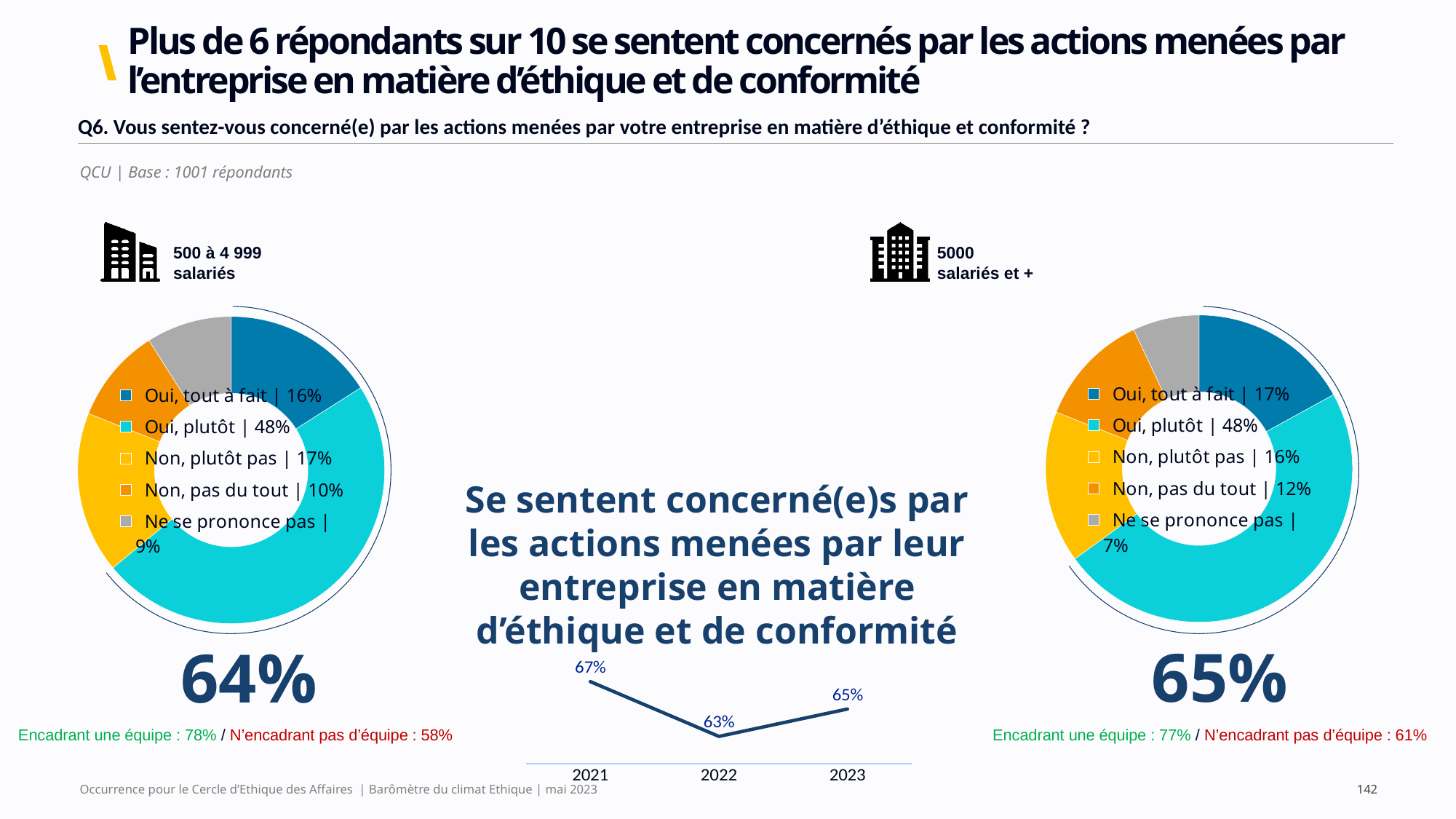
In the right donut chart (5000 salariés et +), which response category has the smallest share? Ne se prononce pas In the left donut chart (500 à 4 999 salariés), what percentage answered "Oui, plutôt"? 48% In the right donut chart (5000 salariés et +), what percentage answered "Oui, tout à fait"? 17% How many response categories does the legend of the left donut chart (500 à 4 999 salariés) list? 5 In the left donut chart (500 à 4 999 salariés), which response category has the largest share? Oui, plutôt In the center line chart, what is the value for 2022? 63% In the right donut chart (5000 salariés et +), what is the difference between the "Oui, plutôt" share and the "Non, plutôt pas" share? 32 percentage points Which is larger: the "Non, pas du tout" share in the left donut chart (500 à 4 999 salariés) or in the right donut chart (5000 salariés et +)? Right donut chart (5000 salariés et +) What type of chart is shown in the center of the slide, below the text "Se sentent concerné(e)s par les actions menées par leur entreprise"? Line chart In the center line chart, which year has the highest value? 2021 In the left donut chart (500 à 4 999 salariés), what percentage answered "Non, pas du tout"? 10% In the right donut chart (5000 salariés et +), what percentage answered "Ne se prononce pas"? 7%